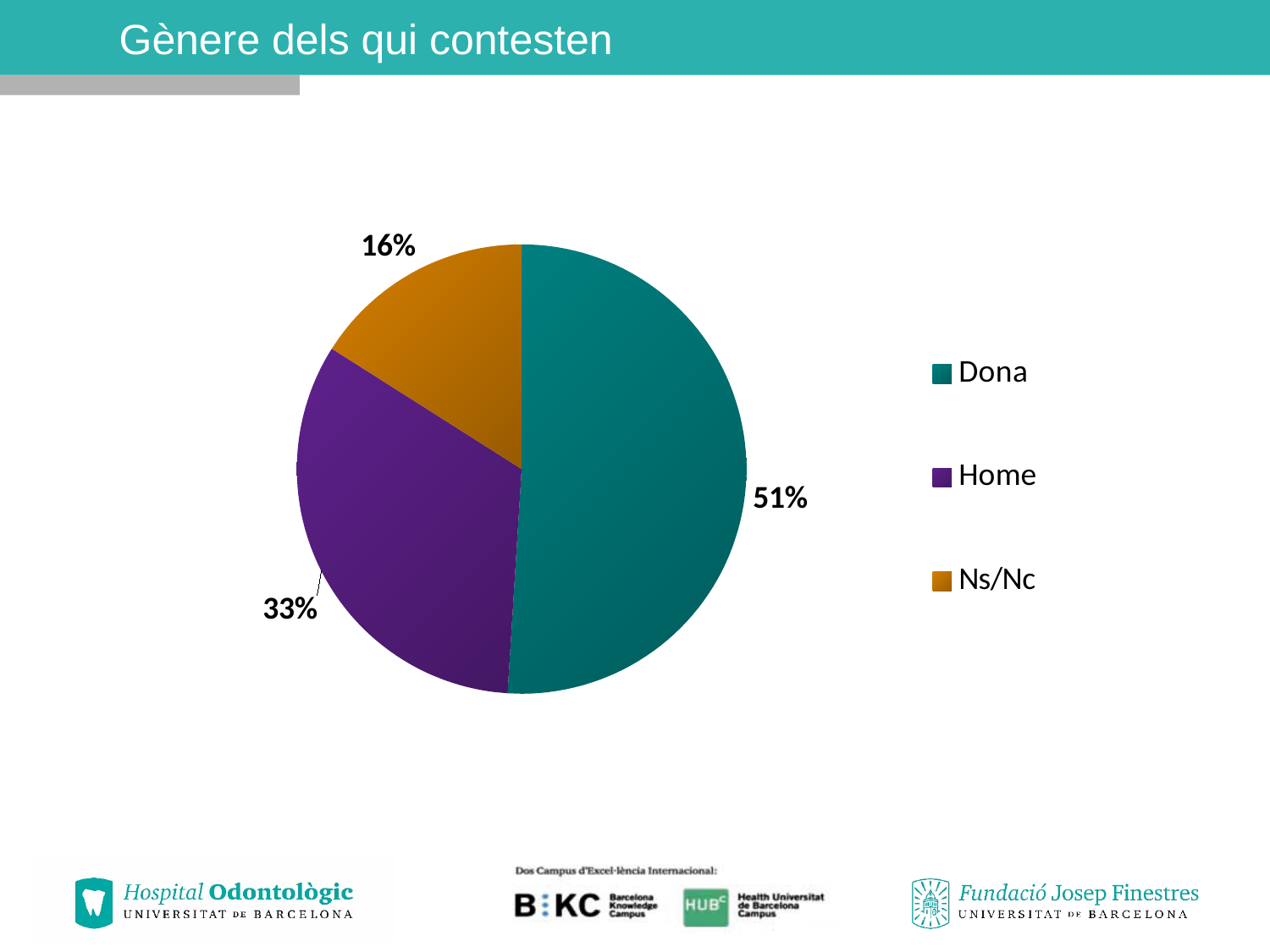
What colour is the slice for Home? purple What share of respondents are Dona? 51% Which category has the smallest slice of the pie? Ns/Nc How many categories does the pie chart have? 3 What is the title of the slide? Gènere dels qui contesten Which is larger, the share for Home or the share for Ns/Nc? Home What share of respondents are Ns/Nc? 16% What is the difference in percentage points between Home and Ns/Nc? 17 Which category has the largest slice of the pie? Dona What kind of chart is shown on the slide? pie chart What share of respondents are Home? 33% What is the difference in percentage points between Dona and Home? 18